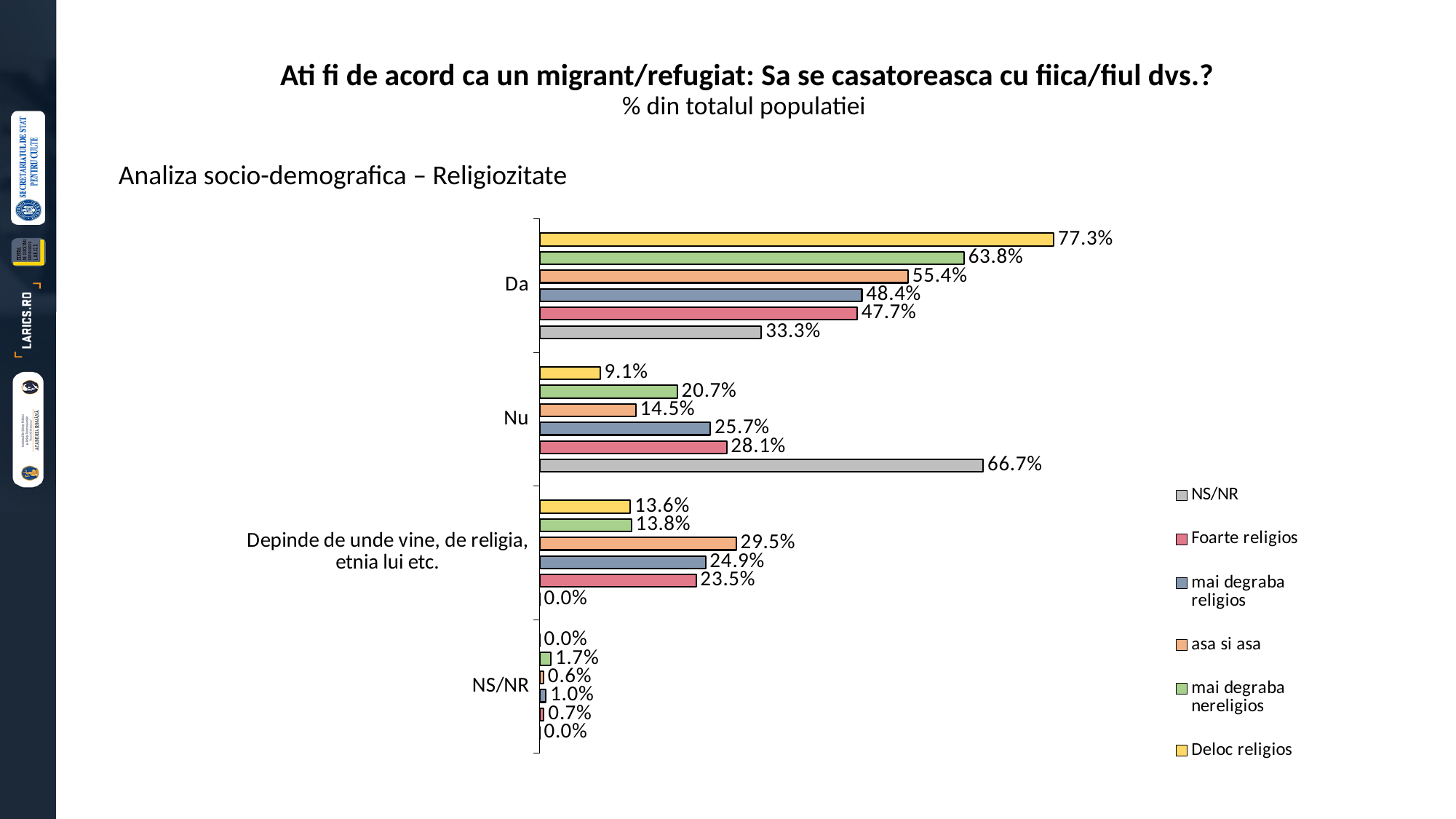
How many series does the legend list? 6 In the "Nu" category, which is larger: "mai degraba religios" or "asa si asa"? mai degraba religios How many response categories are shown on the vertical axis? 4 Which series has the highest value in the "Nu" category? NS/NR What is the subtitle shown under the chart's main title? % din totalul populatiei What is the difference between the "Deloc religios" and "Foarte religios" values in the "Da" category? 29.6% What is the value for "mai degraba nereligios" in the "NS/NR" category? 1.7% What is the value for "asa si asa" in the "Depinde de unde vine, de religia, etnia lui etc." category? 29.5% What kind of chart is shown on the slide? bar chart What is the value for "Deloc religios" in the "Da" category? 77.3% What is the value for "Foarte religios" in the "Nu" category? 28.1% Which series has the lowest value in the "Da" category? NS/NR